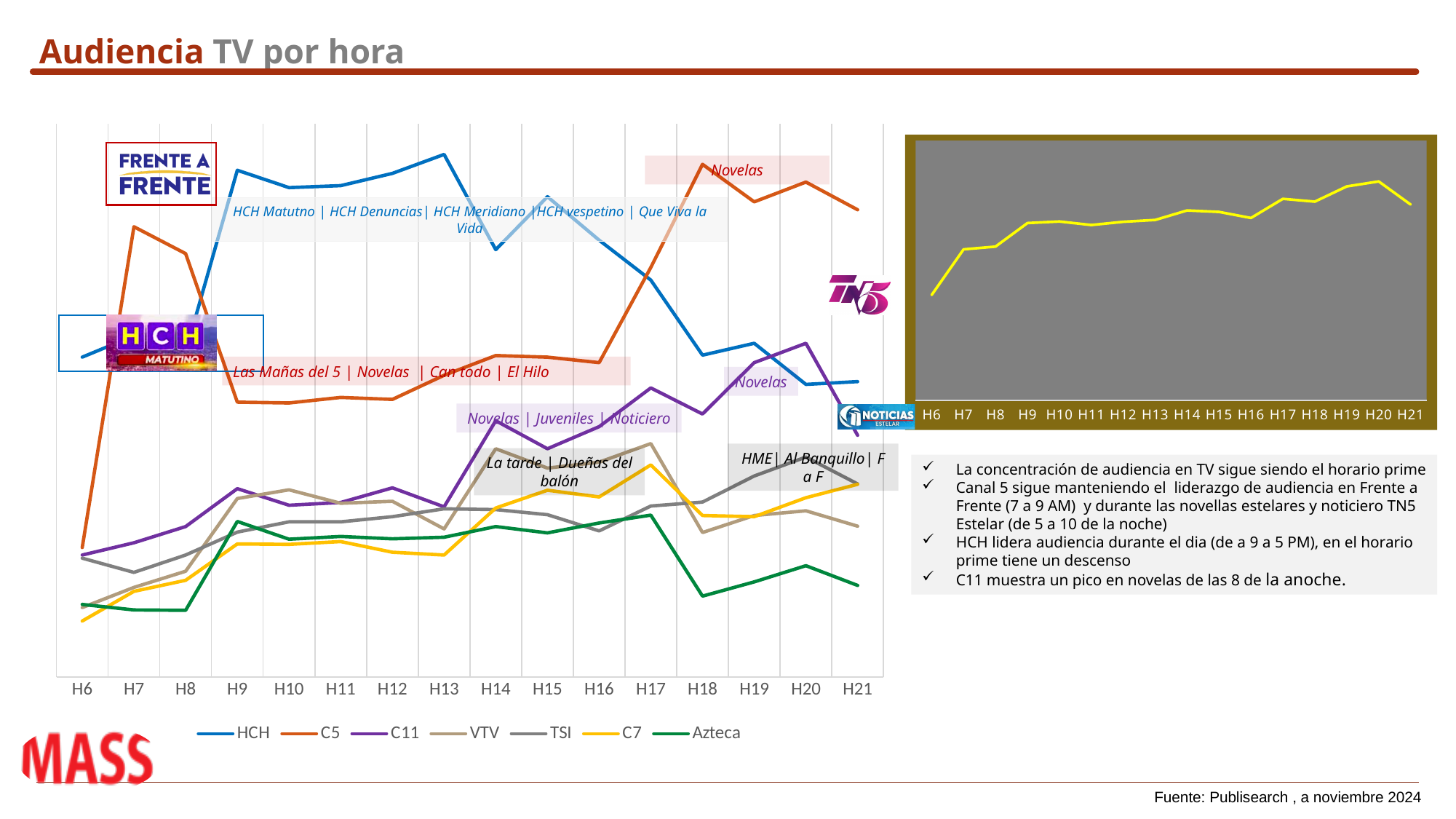
In the main chart, at which hour does the HCH line reach its highest point? H13 In the main chart, at which hour is the C7 line at its lowest? H6 In the main chart, which series has the highest value at H21? C5 In the main chart, which is higher at H14, C11 or VTV? C11 In the main chart, which series has the lowest value at H21? Azteca What kind of chart is the main chart on the left of the slide? line chart What are the legend entries of the main chart, in order? HCH, C5, C11, VTV, TSI, C7, Azteca In the small chart on the right with the yellow line, do the values generally rise or fall from H6 to H20? rise How many hour categories are shown on the x axis of the main chart? 16 How many series does the legend of the main chart list? 7 In the main chart, which is higher at H10, HCH or C5? HCH In the main chart, at which hour does the C5 line reach its highest point? H18